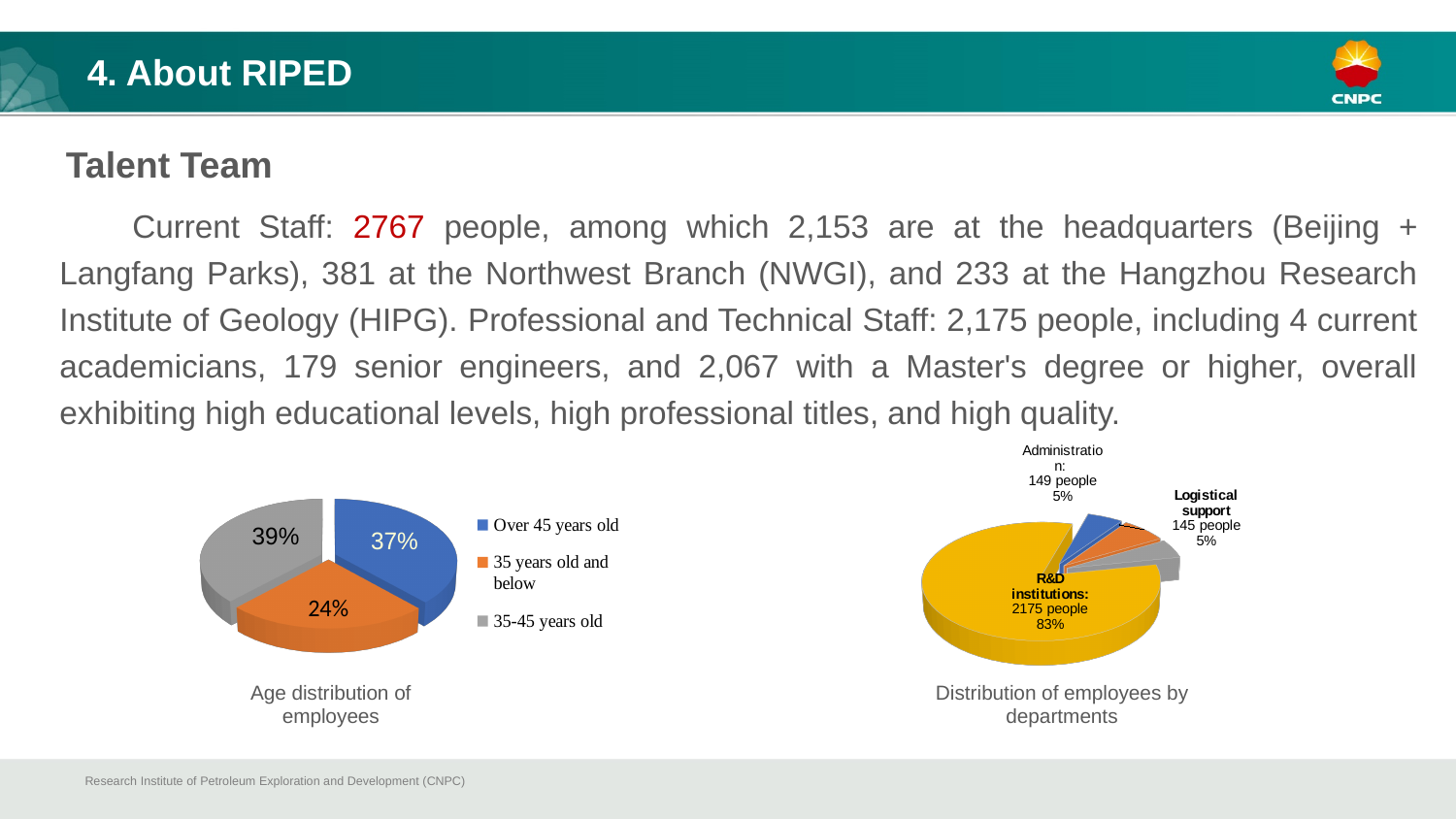
In the 'Distribution of employees by departments' chart, which has more people, Administration or Logistical support? Administration In the 'Age distribution of employees' chart, what share of employees are over 45 years old? 37% In the 'Age distribution of employees' chart, what is the difference between the share of employees aged 35-45 and those 35 years old and below? 15% In the 'Distribution of employees by departments' chart, what percentage of employees are in R&D institutions? 83% In the 'Distribution of employees by departments' chart, how many people are in R&D institutions? 2175 people In the 'Age distribution of employees' chart, which age group has the largest share? 35-45 years old In the 'Age distribution of employees' chart, which age group has the smallest share? 35 years old and below What type of chart is the 'Age distribution of employees' chart? Pie chart In the 'Age distribution of employees' chart, what share of employees are 35 years old and below? 24% In the 'Age distribution of employees' chart, how many age groups does the legend list? 3 In the 'Age distribution of employees' chart, what share of employees are 35-45 years old? 39% In the 'Distribution of employees by departments' chart, what is the difference in headcount between Administration and Logistical support? 4 people